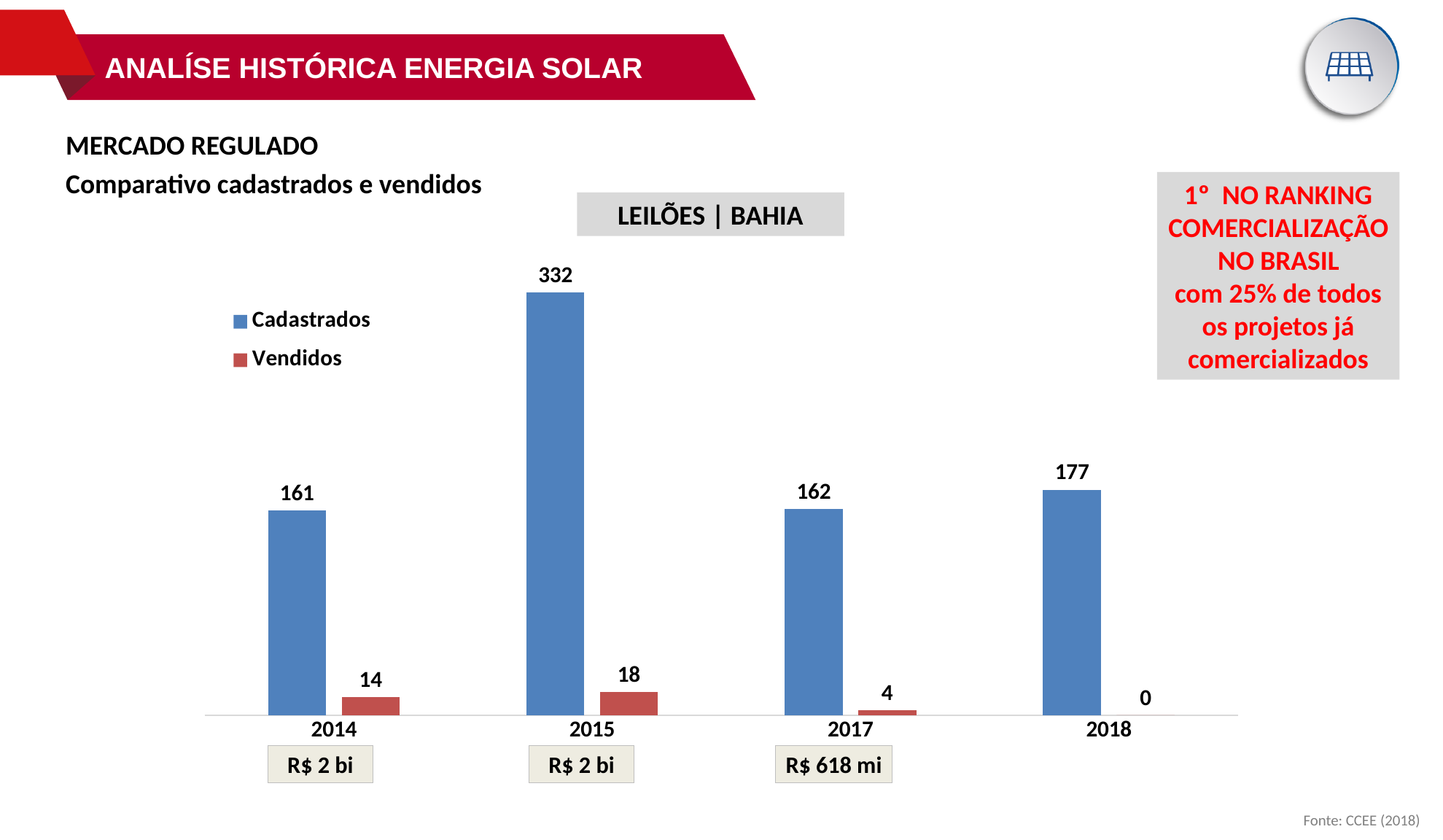
What is the Vendidos value for 2017? 4 What is the title shown above the chart? LEILÕES | BAHIA What is the Vendidos value for 2018? 0 What is the difference between Cadastrados and Vendidos in 2014? 147 What is the difference between the Cadastrados values for 2015 and 2017? 170 Which is larger, the Cadastrados value for 2018 or for 2017? 2018 Which year has the lowest Vendidos value? 2018 How many series does the legend list? 2 What is the Cadastrados value for 2015? 332 Which year has the highest Cadastrados value? 2015 How many years are shown on the x axis? 4 What kind of chart is shown? bar chart